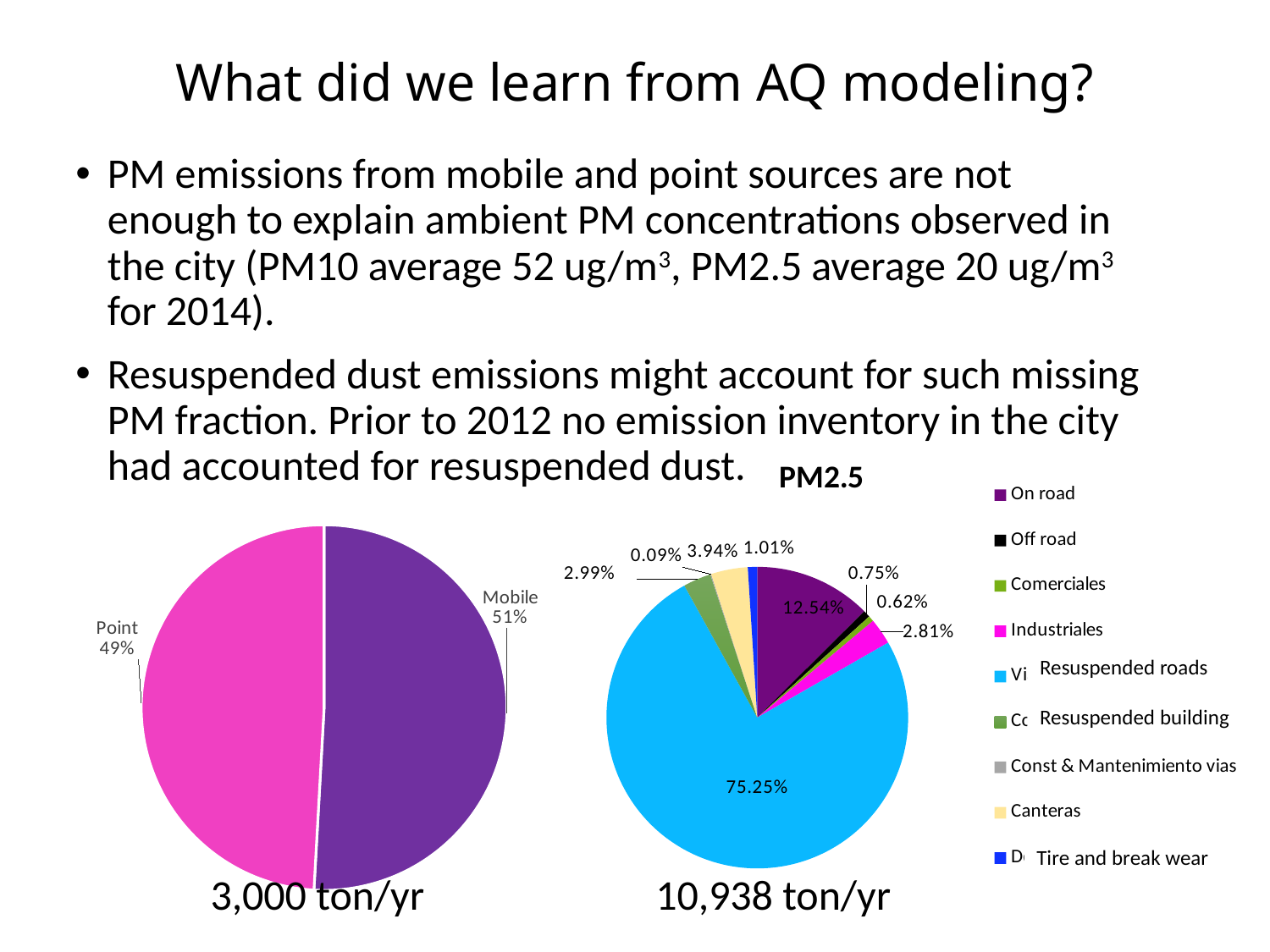
What total is printed below the PM2.5 pie chart? 10,938 ton/yr How many categories does the legend of the PM2.5 pie chart list? 9 In the left pie chart, what share is labeled for Mobile? 51% In the left pie chart, what share is labeled for Point? 49% In the left pie chart, which slice is larger, Mobile or Point? Mobile In the PM2.5 pie chart, what percentage is labeled for On road? 12.54% What total is printed below the left pie chart? 3,000 ton/yr In the PM2.5 pie chart, which category has the largest share? Resuspended roads What kind of charts are shown on the slide? Pie charts In the PM2.5 pie chart, what is the difference between the Resuspended roads share and the On road share? 62.71% In the PM2.5 pie chart, what percentage is labeled for Resuspended roads? 75.25% In the PM2.5 pie chart, which category has the smallest share? Const & Mantenimiento vias